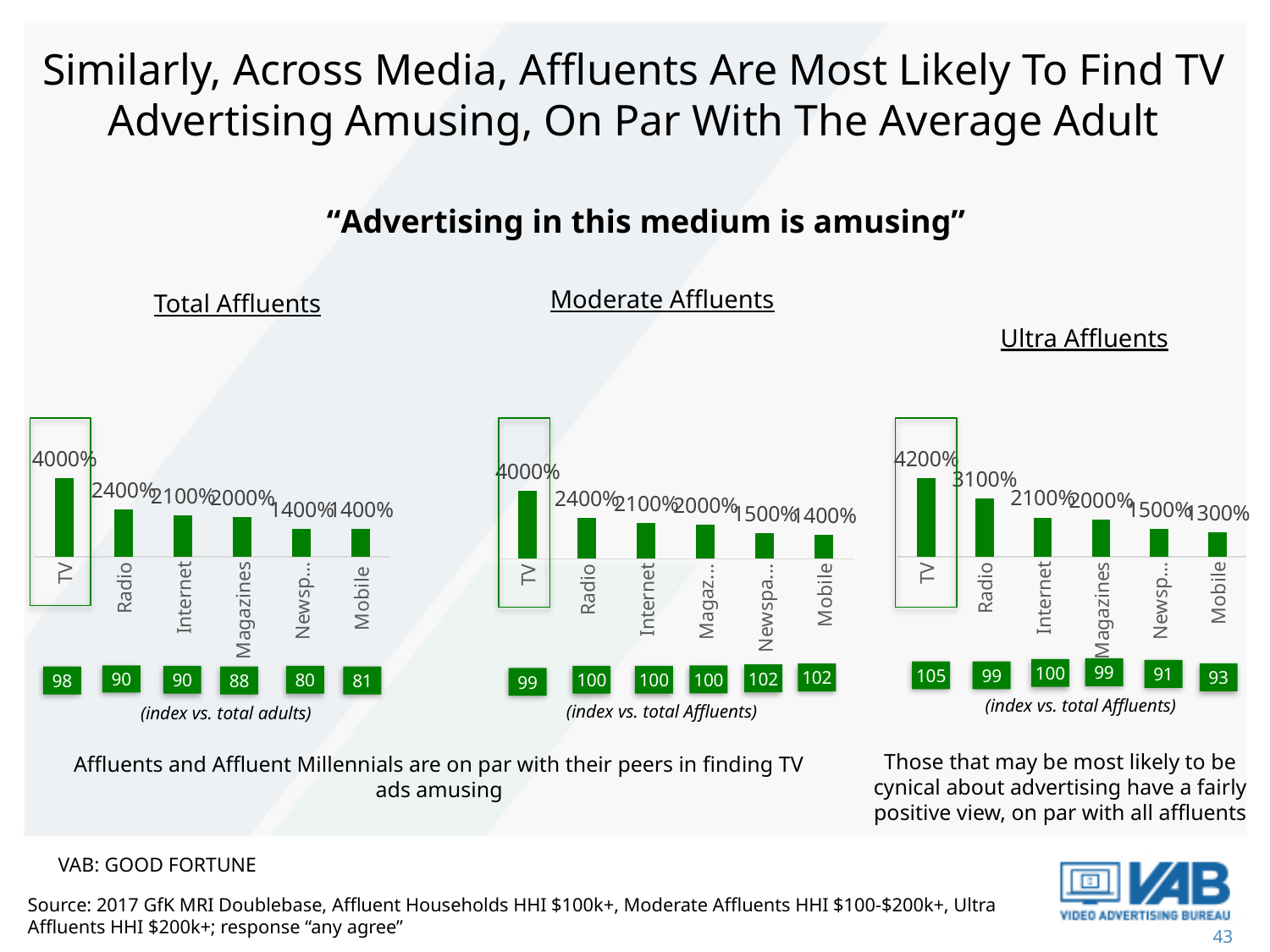
In the Moderate Affluents chart, do the values rise or fall moving from TV to Mobile along the x axis? Fall In the Total Affluents chart, which is larger, the value for Radio or the value for Internet? Radio How many categories are plotted in the Moderate Affluents chart? 6 In the Ultra Affluents chart, what is the data label shown for Radio? 3100% How many bar charts are shown on the slide? 3 In the Ultra Affluents chart, which category has the lowest value? Mobile In the Ultra Affluents chart, what is the difference between the TV label and the Radio label? 1100% In the Total Affluents chart, what is the data label shown for TV? 4000% In the Moderate Affluents chart, what is the data label shown for Mobile? 1400% In the Total Affluents chart, which category has the highest value? TV What type of chart is the Ultra Affluents chart? Bar chart In the Total Affluents chart, what is the data label shown for Magazines? 2000%